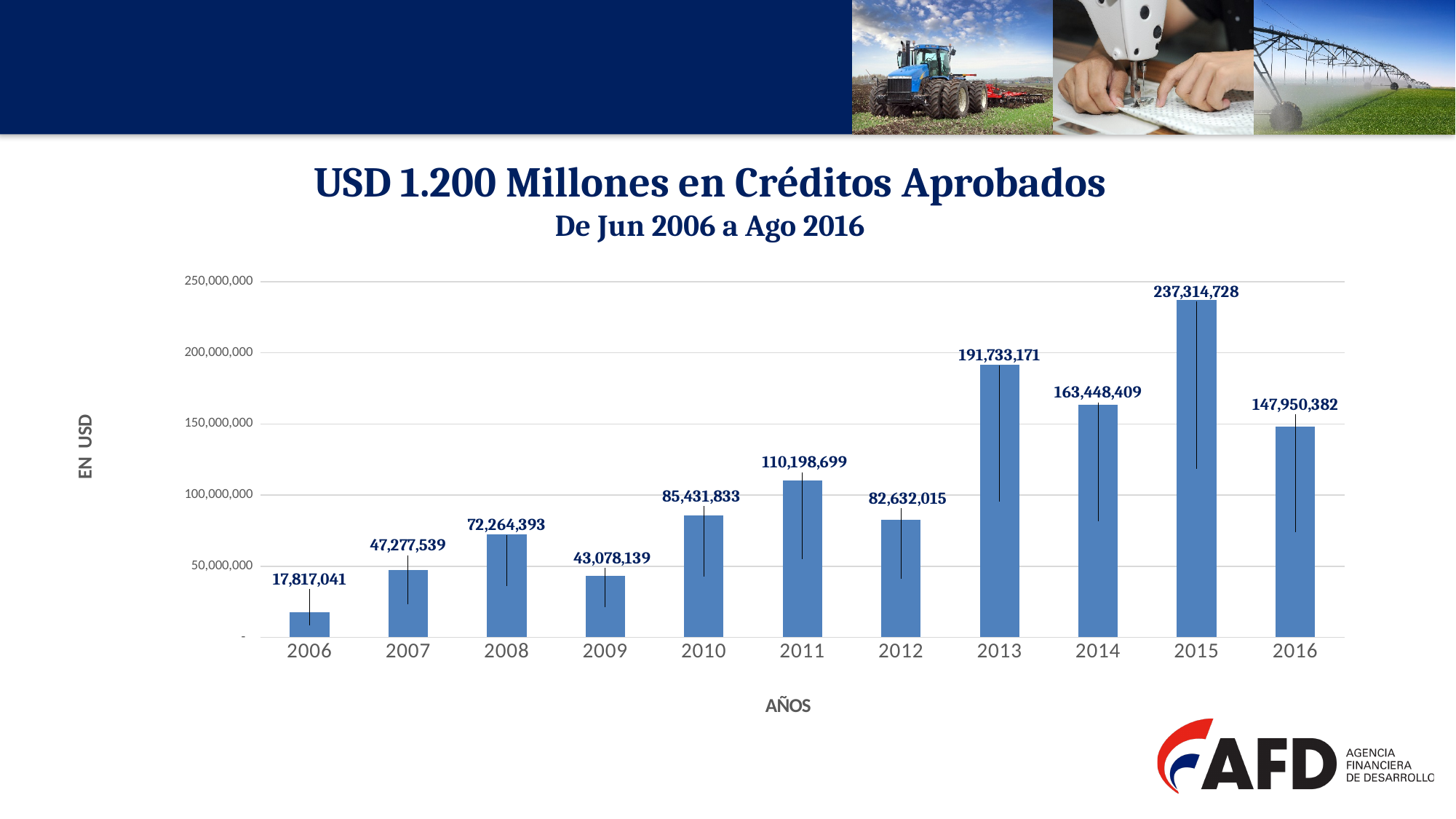
What is the value for 2015? 237,314,728 What kind of chart is shown on the slide? bar chart What is the value for 2009? 43,078,139 Which is larger, the value for 2010 or the value for 2012? 2010 What is the label of the y axis? EN USD Is the value for 2011 greater or less than 100,000,000? greater What is the value for 2012? 82,632,015 How many years are shown on the x axis? 11 What is the difference between the values for 2015 and 2014? 73,866,319 Which year has the highest value? 2015 Which year has the lowest value? 2006 What is the difference between the values for 2013 and 2012? 109,101,156